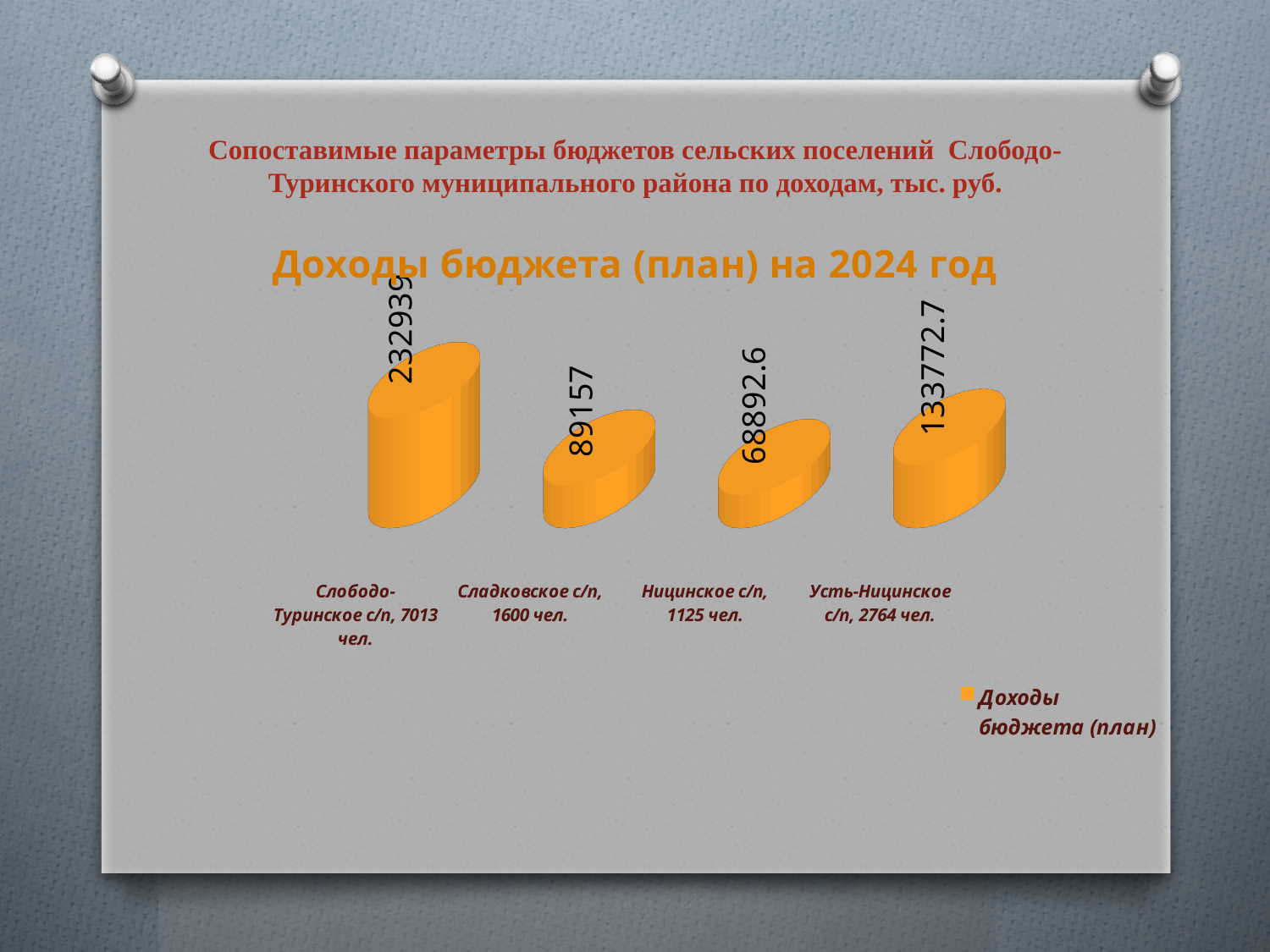
What is the planned budget income value for Ницинское с/п? 68892.6 How many settlements are shown in the chart? 4 What is the difference between the planned budget income of Слободо-Туринское с/п and Усть-Ницинское с/п? 99166.3 What is the planned budget income value for Сладковское с/п? 89157 What type of chart is shown on the slide? Bar chart Which settlement has the highest planned budget income? Слободо-Туринское с/п Which settlement has the lowest planned budget income? Ницинское с/п Which has a larger planned budget income, Сладковское с/п or Усть-Ницинское с/п? Усть-Ницинское с/п What is the title of the chart? Доходы бюджета (план) на 2024 год What is the planned budget income value for Слободо-Туринское с/п? 232939 What is the planned budget income value for Усть-Ницинское с/п? 133772.7 What is the difference between the planned budget income of Сладковское с/п and Ницинское с/п? 20264.4